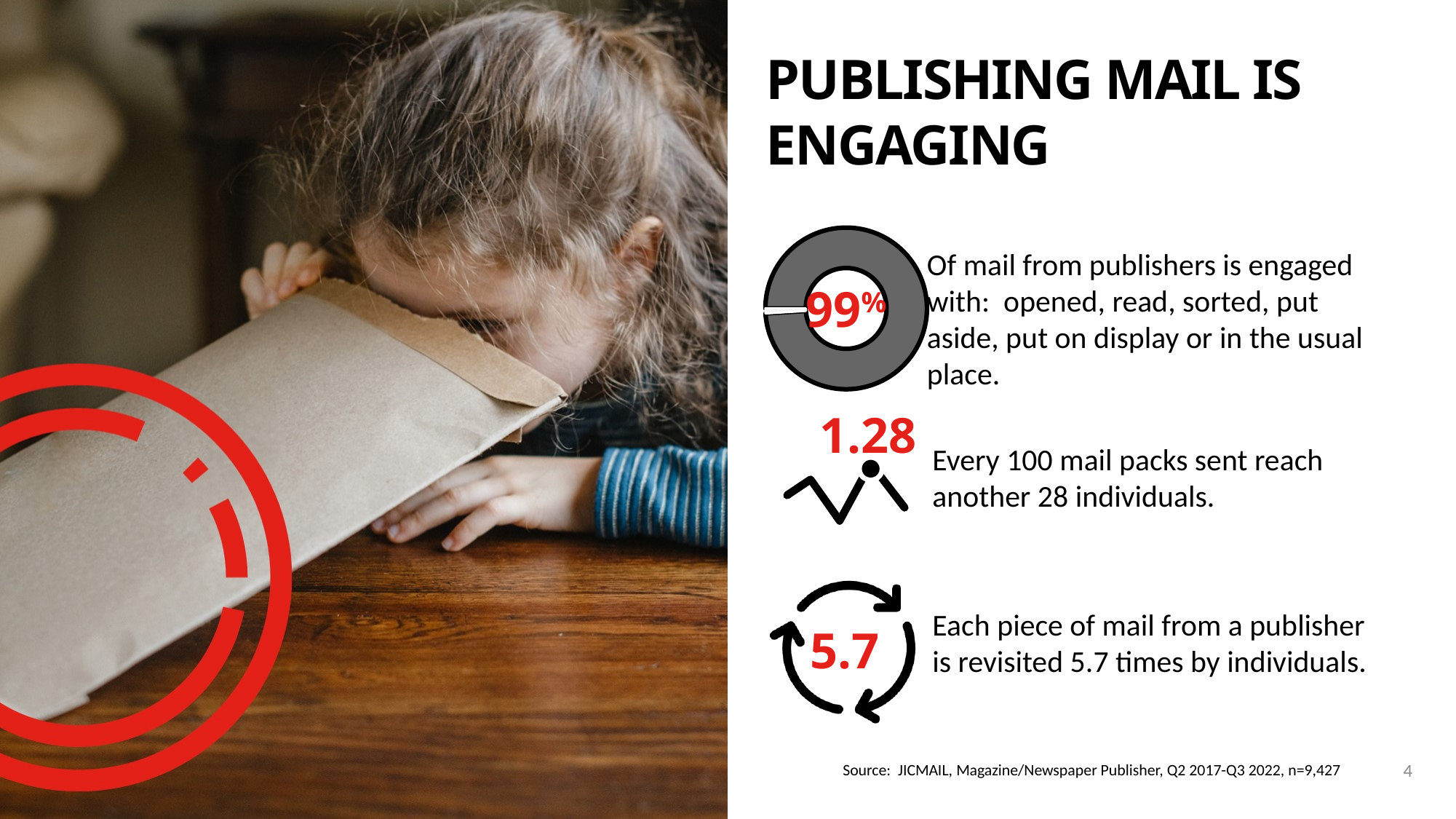
What colour is the large segment of the donut chart? Grey What kind of chart is shown next to the text about mail from publishers being engaged with? Pie (donut) chart What colour is the number printed in the centre of the donut chart? Red Which segment of the donut chart is larger, the grey segment or the thin white sliver? The grey segment According to the donut chart, what share of mail from publishers is engaged with? 99% Is the value shown in the donut chart greater or less than 50%? greater How many segments does the donut chart have? 2 What percentage is printed in the centre of the donut chart? 99%